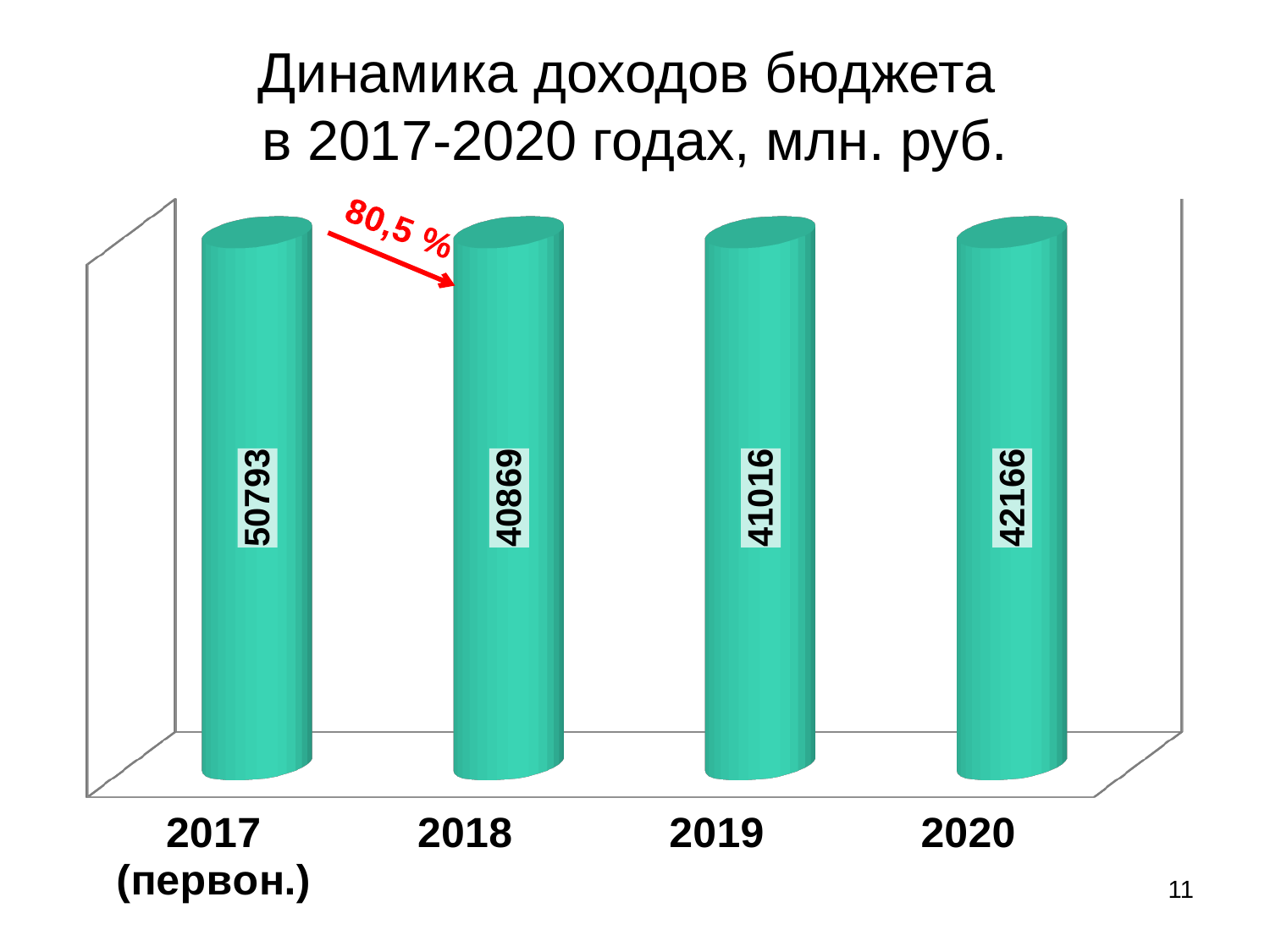
What is the difference between the values for 2017 (первон.) and 2018? 9924 What kind of chart is shown on the slide? Bar chart What percentage is written next to the red arrow between 2017 and 2018? 80,5 % What is the difference between the values for 2020 and 2019? 1150 What is the value shown for 2020? 42166 What is the value shown for 2018? 40869 How many years are shown on the chart? 4 Which year has the highest value on the chart? 2017 (первон.) What is the budget revenue value shown for 2017 (первон.)? 50793 Which is larger, the value for 2019 or the value for 2020? 2020 What is the value shown for 2019? 41016 Which year has the lowest value on the chart? 2018